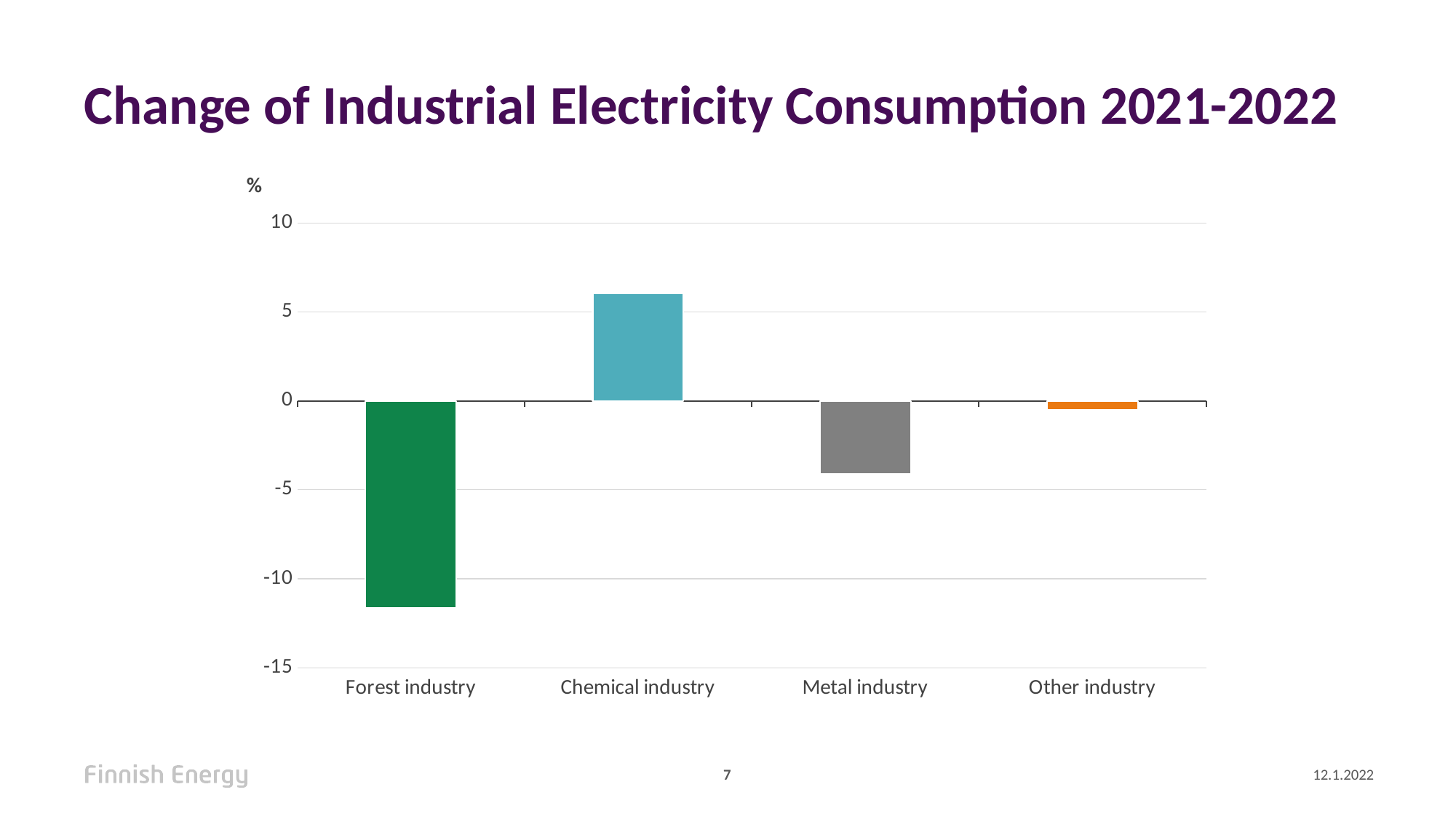
Which has the larger value, Forest industry or Metal industry? Metal industry What is the title of the chart? Change of Industrial Electricity Consumption 2021-2022 How many industry categories are plotted on the chart? 4 Which industry shows the lowest change in electricity consumption? Forest industry Is the value for Metal industry greater or less than 0? less What kind of chart is shown on the slide? bar chart Is the value for Metal industry greater or less than -5? greater Is the value for Chemical industry greater or less than 5? greater What unit is shown on the vertical axis of the chart? % Which industry shows the highest change in electricity consumption? Chemical industry Which has the larger value, Metal industry or Other industry? Other industry